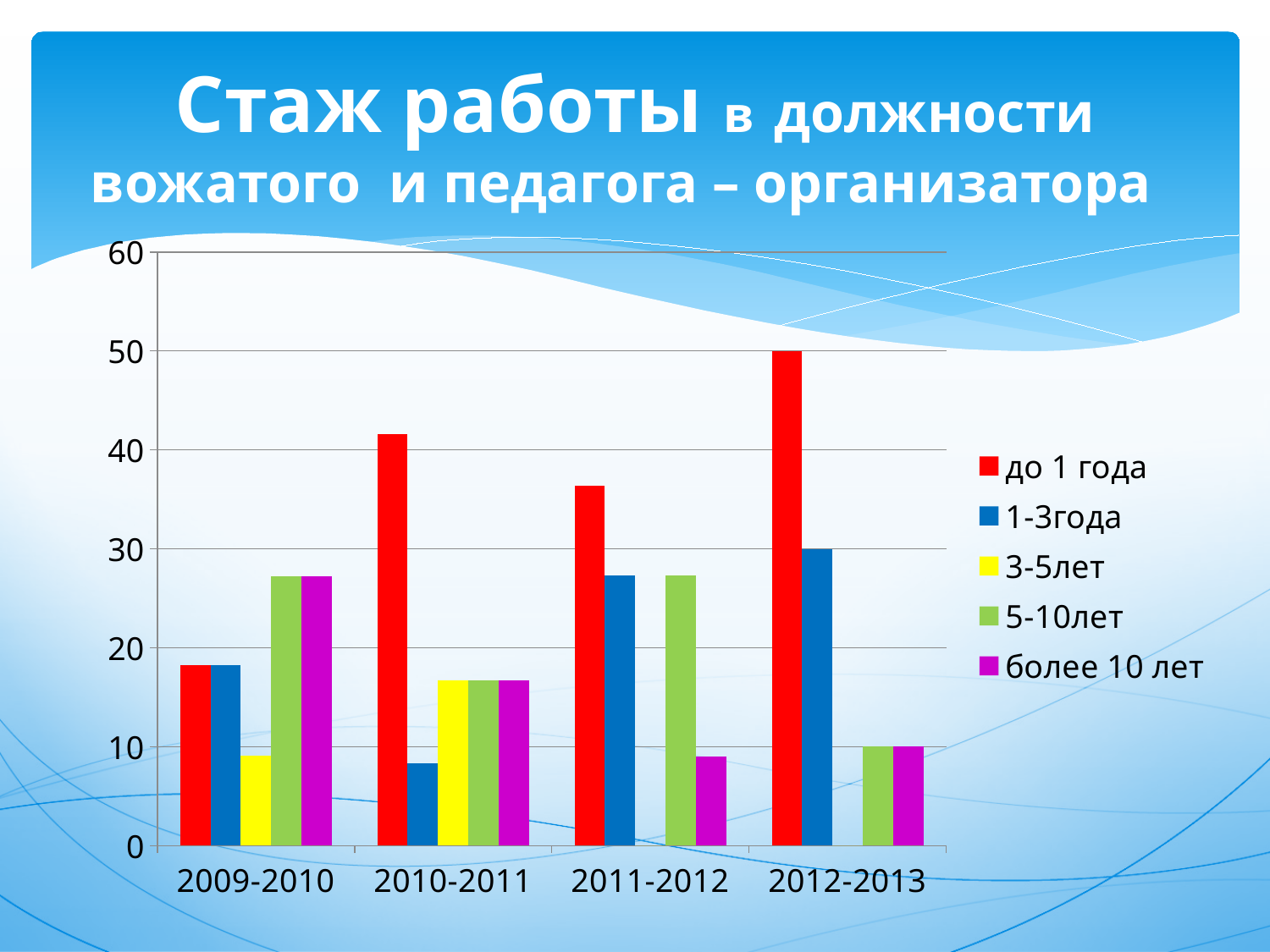
What is the value for "1-3года" in 2012-2013? 30 Is the value for "1-3года" in 2010-2011 greater or less than 10? less What is the value for "5-10лет" in 2012-2013? 10 What kind of chart is shown on the slide? bar chart How many series does the legend list? 5 Is the value for "до 1 года" in 2010-2011 greater or less than 40? greater In which year category is the value for "до 1 года" lowest? 2009-2010 Which is larger in 2011-2012: the value for "до 1 года" or the value for "1-3года"? до 1 года Does the value for "до 1 года" rise or fall from 2011-2012 to 2012-2013? rise How many year categories are shown on the x axis? 4 What is the value for "до 1 года" in 2012-2013? 50 In which year category is the value for "до 1 года" highest? 2012-2013